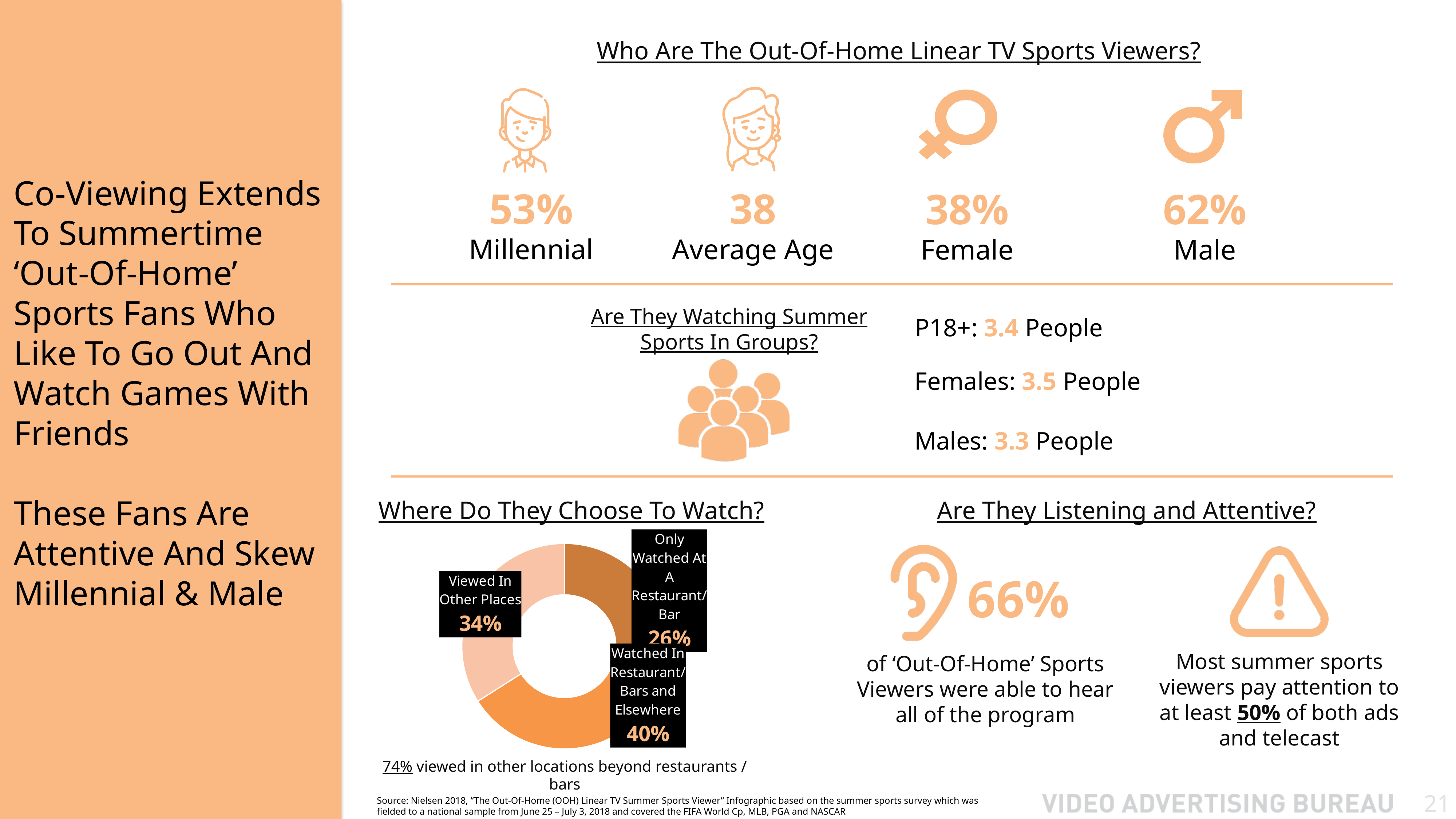
What kind of chart is shown under "Where Do They Choose To Watch?"? Pie chart (donut) In the "Where Do They Choose To Watch?" chart, which category has the smallest share? Only Watched At A Restaurant/Bar In the "Where Do They Choose To Watch?" chart, what is the difference in percentage points between "Viewed In Other Places" and "Only Watched At A Restaurant/Bar"? 8 percentage points In the "Where Do They Choose To Watch?" chart, what is the combined share of "Viewed In Other Places" and "Watched In Restaurant/Bars and Elsewhere"? 74% In the "Where Do They Choose To Watch?" chart, how many slices are there? 3 What is the title of the donut chart on the slide? Where Do They Choose To Watch? In the "Where Do They Choose To Watch?" chart, what share is labelled "Watched In Restaurant/Bars and Elsewhere"? 40% In the "Where Do They Choose To Watch?" chart, which is larger: "Viewed In Other Places" or "Only Watched At A Restaurant/Bar"? Viewed In Other Places In the "Where Do They Choose To Watch?" chart, what share is labelled "Only Watched At A Restaurant/Bar"? 26% In the "Where Do They Choose To Watch?" chart, what share is labelled "Viewed In Other Places"? 34% In the "Where Do They Choose To Watch?" chart, what is the difference in percentage points between "Watched In Restaurant/Bars and Elsewhere" and "Only Watched At A Restaurant/Bar"? 14 percentage points In the "Where Do They Choose To Watch?" chart, which category has the largest share? Watched In Restaurant/Bars and Elsewhere